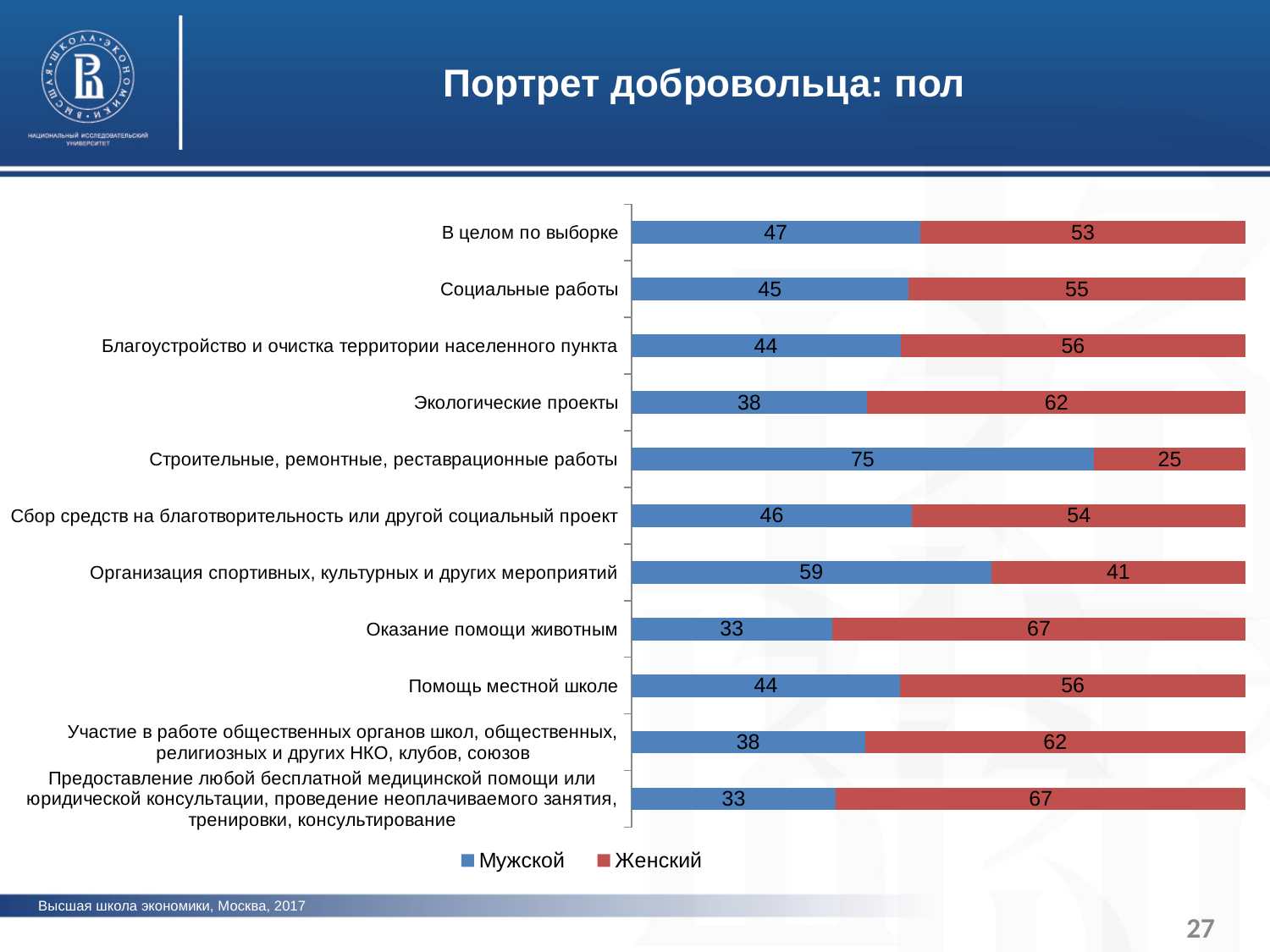
How many categories are shown on the chart? 11 What kind of chart is shown on the slide? Stacked bar chart What is the value for Женский in the category Оказание помощи животным? 67 Which category has the highest value for Мужской? Строительные, ремонтные, реставрационные работы What is the value for Мужской in the category Экологические проекты? 38 How many series does the legend list? 2 What is the difference between the Женский and Мужской values for Организация спортивных, культурных и других мероприятий? 18 Which is larger for Социальные работы: the Мужской value or the Женский value? Женский What is the title of the slide? Портрет добровольца: пол What is the value for Мужской in the category В целом по выборке? 47 Which category has the lowest value for Женский? Строительные, ремонтные, реставрационные работы What is the total of the stacked bar for Помощь местной школе? 100